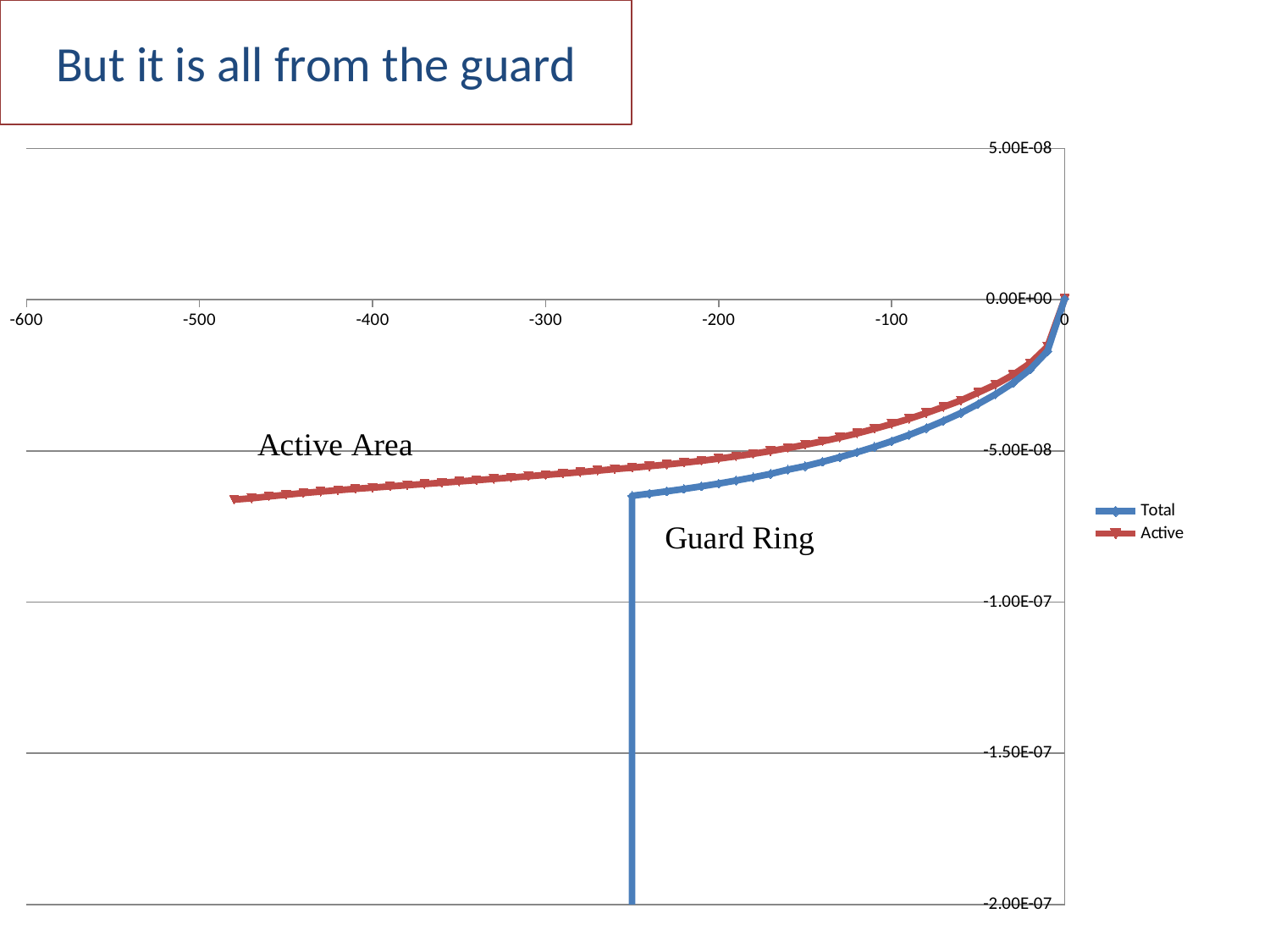
Is the value of the Active series at x = -100 greater or less than -5.00E-08? greater What is the value of the Total series at x = 0? 0.00E+00 How many series does the legend list? 2 Is the value of the Total series at x = -200 greater or less than -5.00E-08? less Which colour is used for the Total series? blue Is the value of the Active series at its leftmost point (near x = -480) greater or less than -5.00E-08? less At x = -200, which series has the higher value, Total or Active? Active What kind of chart is shown on the slide? line chart Do the values of the Active series rise or fall as x increases from -480 toward 0? rise Which series reaches the lowest value on the chart? Total What are the names of the two series in the legend? Total and Active